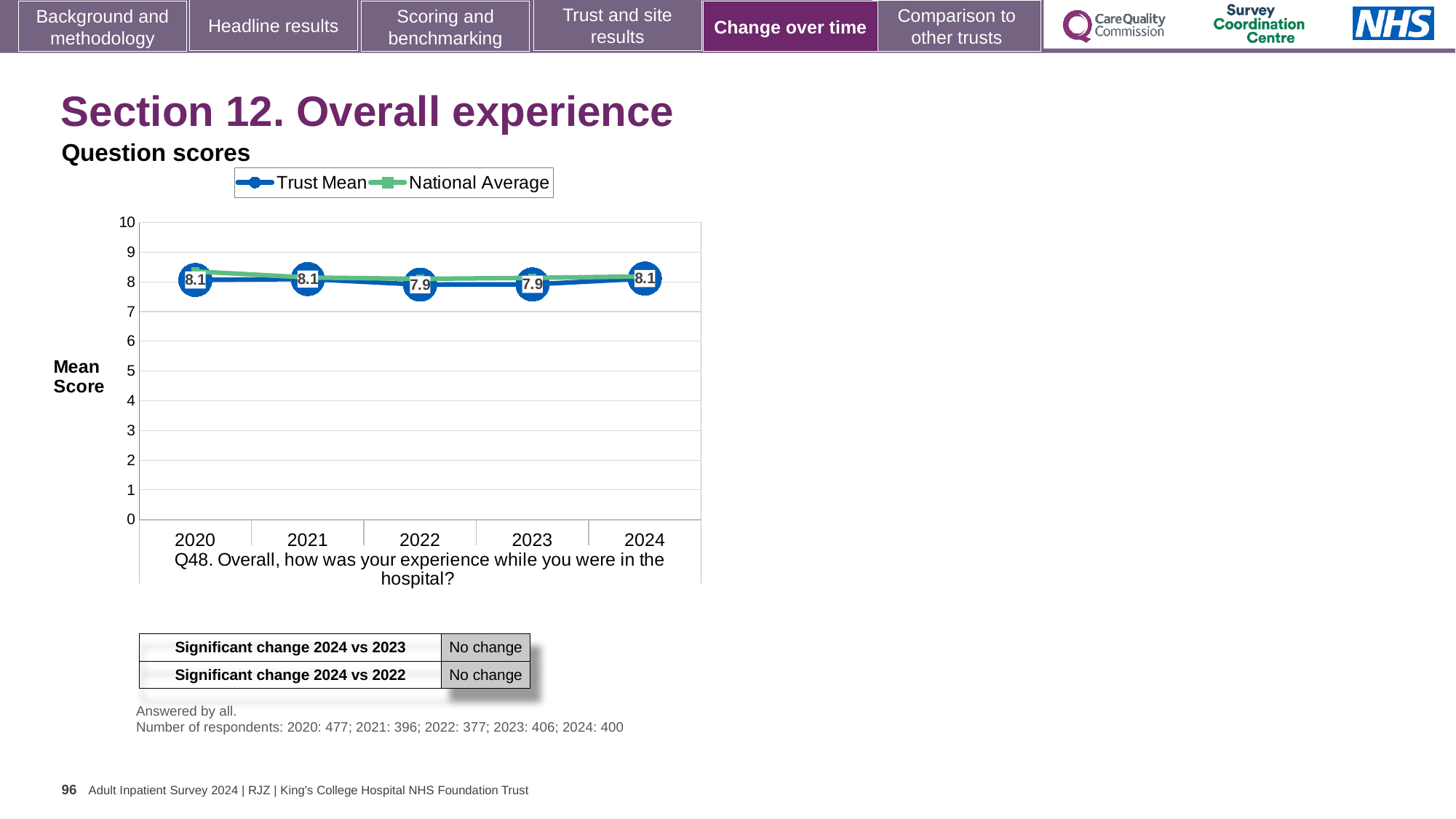
What is the Trust Mean score for 2023? 7.9 What is the Trust Mean score for 2024? 8.1 What is the difference between the Trust Mean score in 2024 and in 2023? 0.2 How many years are plotted on the x axis of the chart? 5 How many series does the chart legend list? 2 What is the Trust Mean score for 2022? 7.9 What is the Trust Mean score for 2020? 8.1 What is the label on the y axis of the chart? Mean Score What kind of chart is shown on the slide? Line chart Which is larger, the Trust Mean score for 2021 or for 2022? 2021 Is the National Average value for 2024 greater or less than 5? greater Which series are listed in the chart legend? Trust Mean and National Average